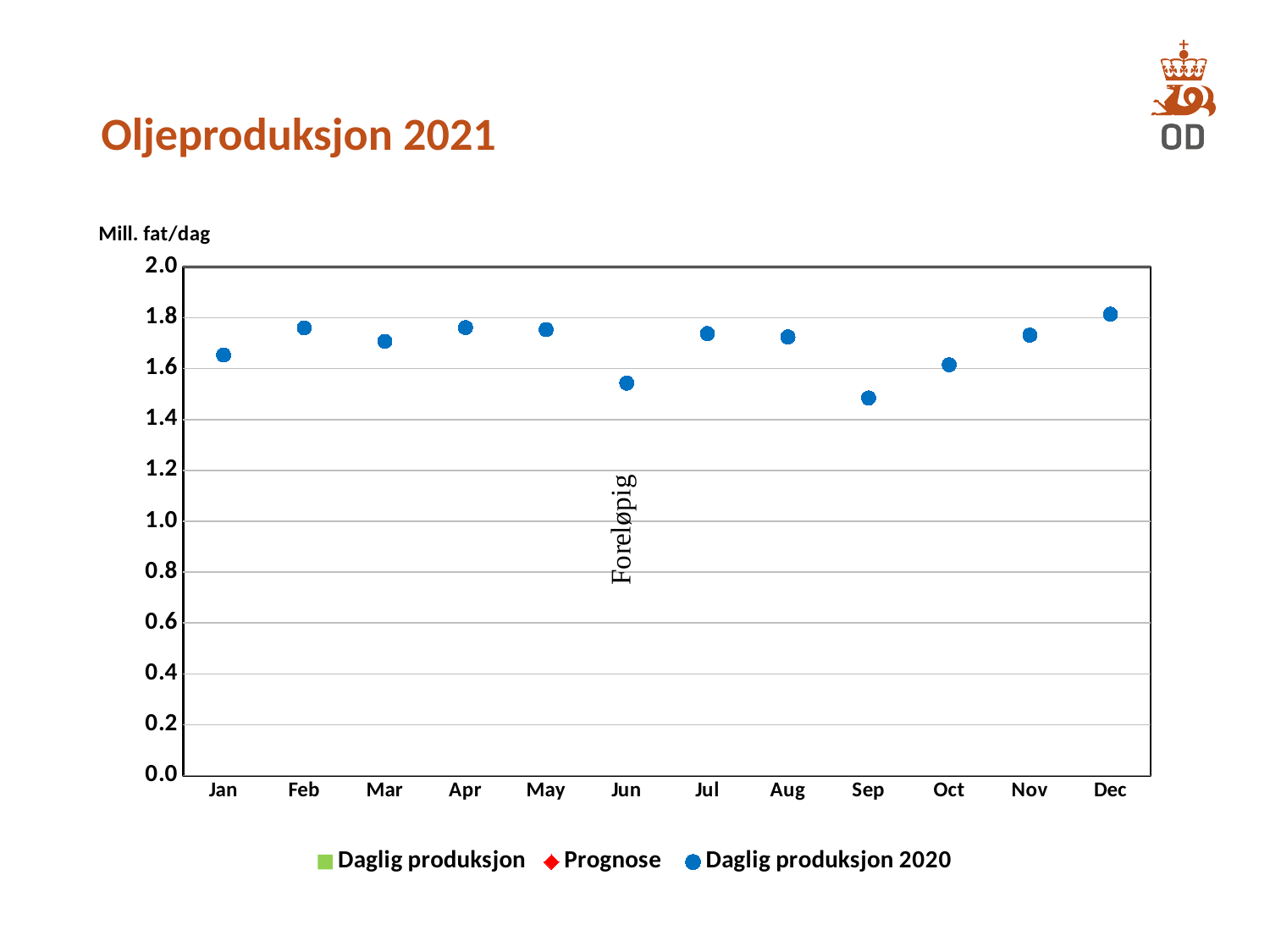
Which month has the lowest value for Daglig produksjon 2020? Sep How many series does the legend list? 3 Which month has the highest value for Daglig produksjon 2020? Dec Is the value for Daglig produksjon 2020 in Feb greater or less than 1.6? greater What is the title of the chart on the slide? Oljeproduksjon 2021 What unit is shown on the y axis of the chart? Mill. fat/dag How many months are shown along the x axis? 12 Is the value for Daglig produksjon 2020 in Sep greater or less than 1.6? less Is the value for Daglig produksjon 2020 in Jun greater or less than 1.6? less Which is larger for Daglig produksjon 2020, Jun or Sep? Jun Which is larger for Daglig produksjon 2020, Oct or Nov? Nov Which is larger for Daglig produksjon 2020, Jan or Feb? Feb